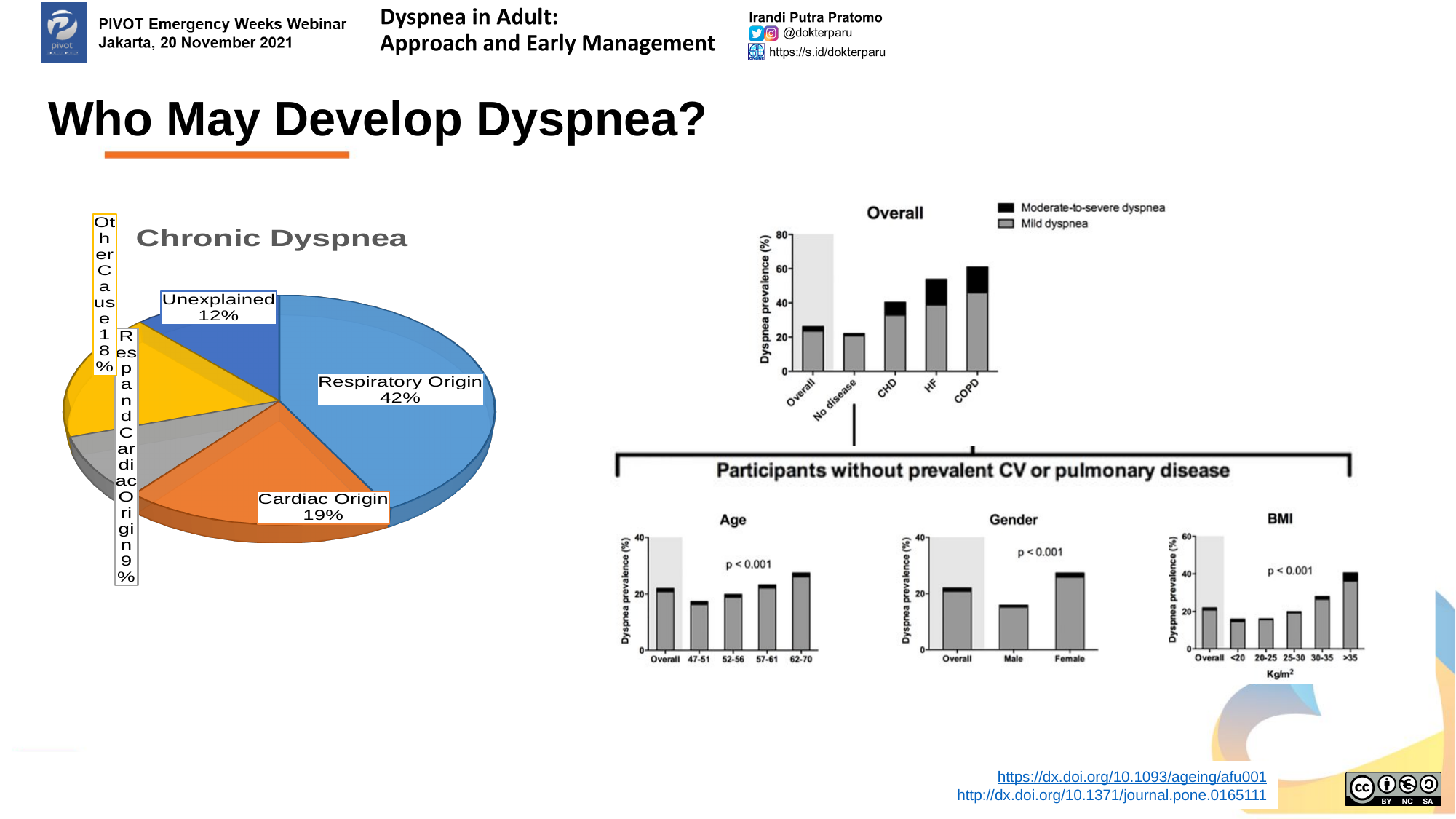
In the BMI bar chart, is the dyspnea prevalence for >35 kg/m² greater or less than 20? greater In the Chronic Dyspnea pie chart, what is the difference in percentage points between Respiratory Origin and Cardiac Origin? 23 percentage points How many slices does the Chronic Dyspnea pie chart have? 5 In the Overall bar chart, is the total dyspnea prevalence for COPD greater or less than 40? greater In the Chronic Dyspnea pie chart, what percentage is attributed to Respiratory Origin? 42% How many series does the legend of the Overall bar chart list? 2 In the Chronic Dyspnea pie chart, which cause has the smallest share? Resp and Cardiac Origin In the Chronic Dyspnea pie chart, which cause has the largest share? Respiratory Origin In the Overall bar chart on the right, which category has the highest dyspnea prevalence? COPD In the Age bar chart, does dyspnea prevalence rise or fall from the 47-51 group to the 62-70 group? rise In the Gender bar chart, which has the higher dyspnea prevalence, Male or Female? Female What kind of chart is the Chronic Dyspnea chart? Pie chart